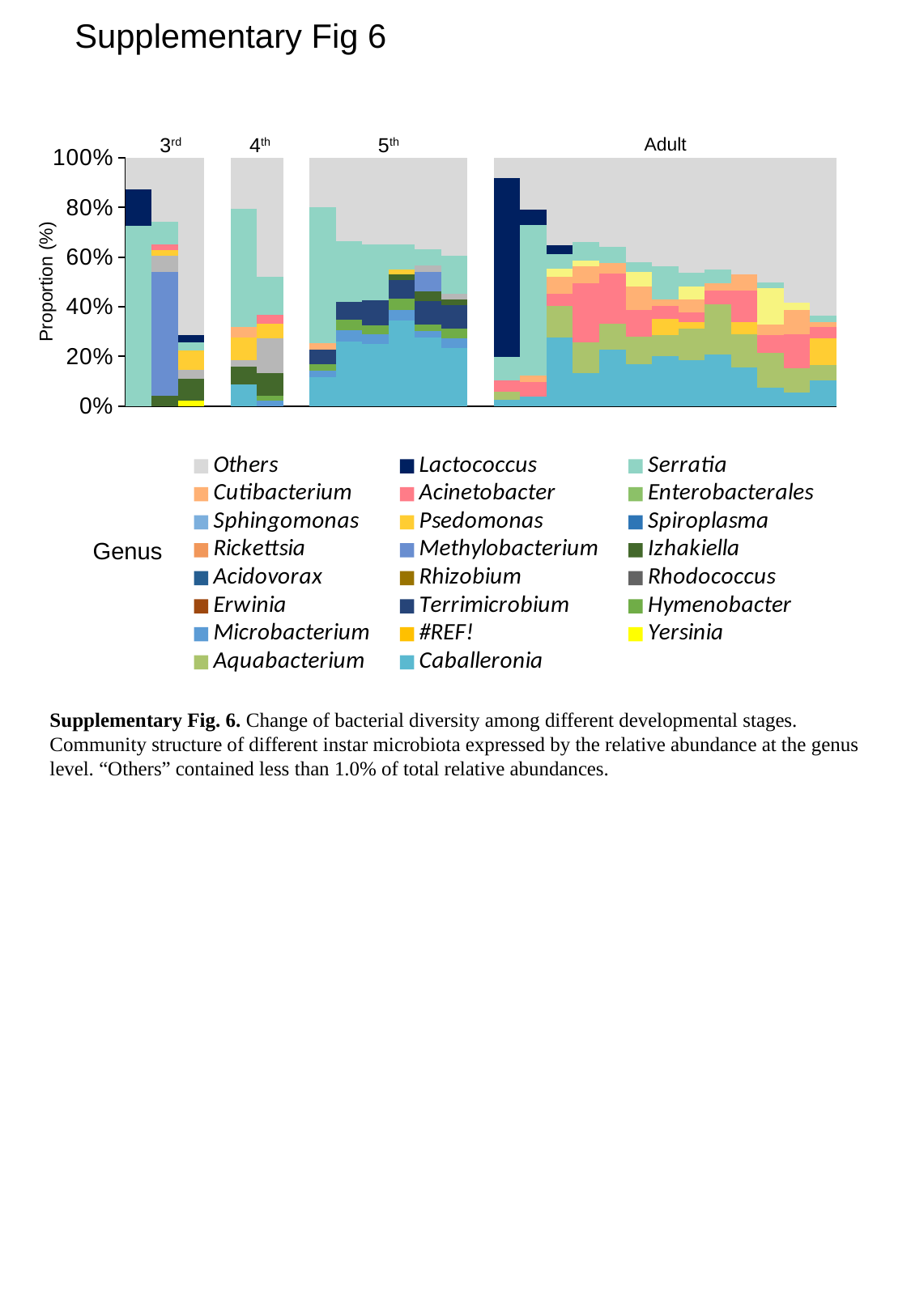
In the first bar of the 3rd instar group, is the top of the Lactococcus segment greater or less than 80%? greater Which developmental stage group has the fewest bars, 3rd or Adult? 3rd What is the highest value shown on the y axis? 100% What is the total height of each stacked bar in the chart? 100% How many genus entries does the legend list? 23 Which developmental stage group contains the most bars? Adult What is the title given to the legend? Genus What kind of chart is shown on the slide? stacked bar chart How many developmental stage groups are labelled along the top of the chart? 4 What is the label of the y axis? Proportion (%)